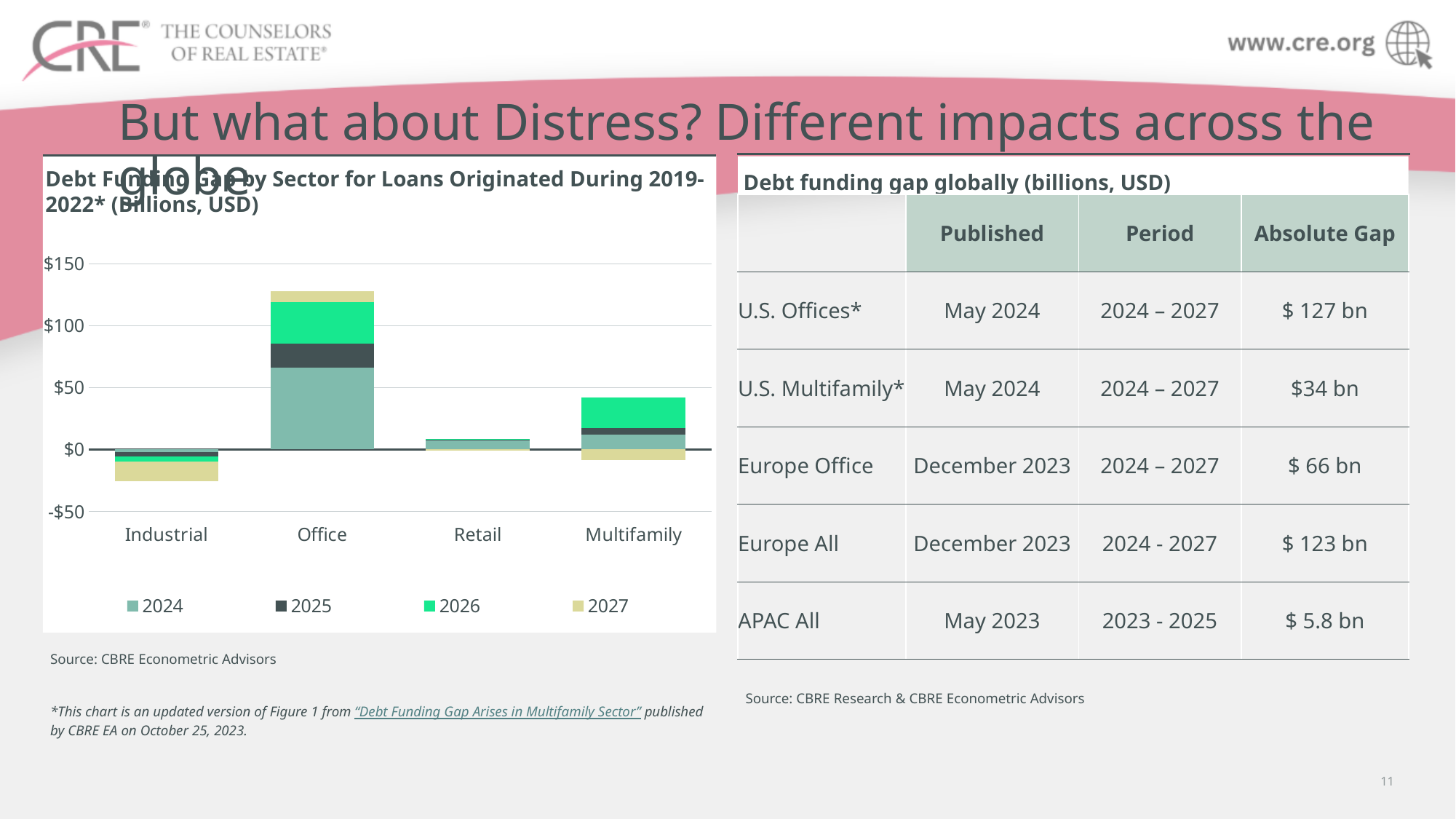
Which sector has the highest total debt funding gap in the chart? Office What kind of chart is shown on the left of the slide? Stacked bar chart Which year in the legend is represented by the bright green colour? 2026 How many sectors are shown on the x axis of the chart? 4 Is the 2024 value for Office greater or less than $50? greater Which sector has a larger positive stacked bar, Retail or Multifamily? Multifamily Is the total stacked value for Office greater or less than $100? greater Which sector has a larger total debt funding gap, Office or Multifamily? Office Which sector has the lowest (most negative) debt funding gap in the chart? Industrial How many series does the chart's legend list? 4 Is the top of the Multifamily stacked bar greater or less than $50? less